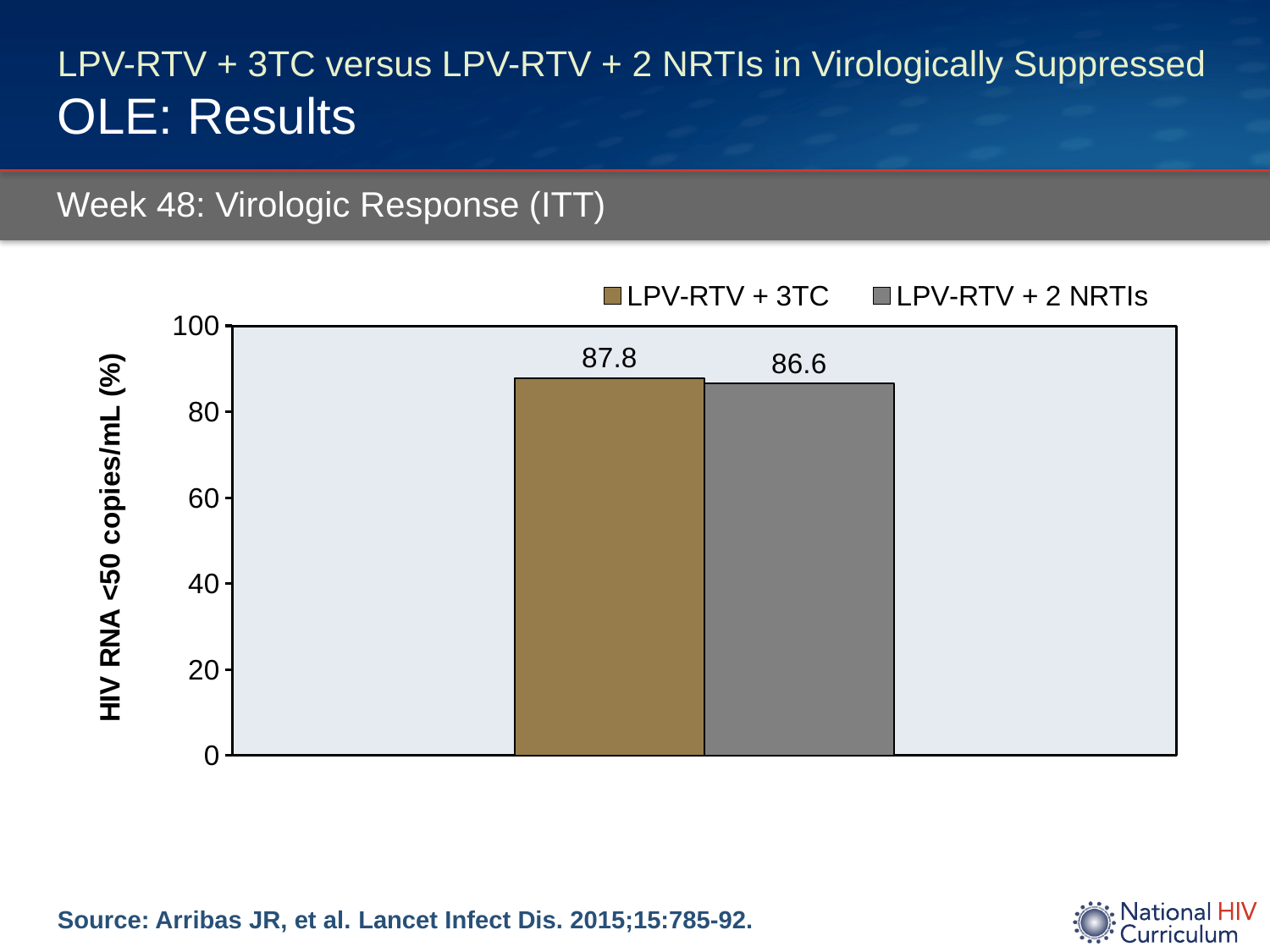
What is the value for LPV-RTV + 3TC? 87.8 How many bars are plotted on the chart? 2 What is the label of the y axis? HIV RNA <50 copies/mL (%) What kind of chart is shown on the slide? Bar chart Is the value for LPV-RTV + 3TC greater or less than 100? less Which series has the higher value, LPV-RTV + 3TC or LPV-RTV + 2 NRTIs? LPV-RTV + 3TC Which series has the lowest value? LPV-RTV + 2 NRTIs What is the maximum value shown on the y axis? 100 What is the difference between the LPV-RTV + 3TC value and the LPV-RTV + 2 NRTIs value? 1.2 What is the value for LPV-RTV + 2 NRTIs? 86.6 Is the value for LPV-RTV + 2 NRTIs greater or less than 80? greater How many series does the legend list? 2